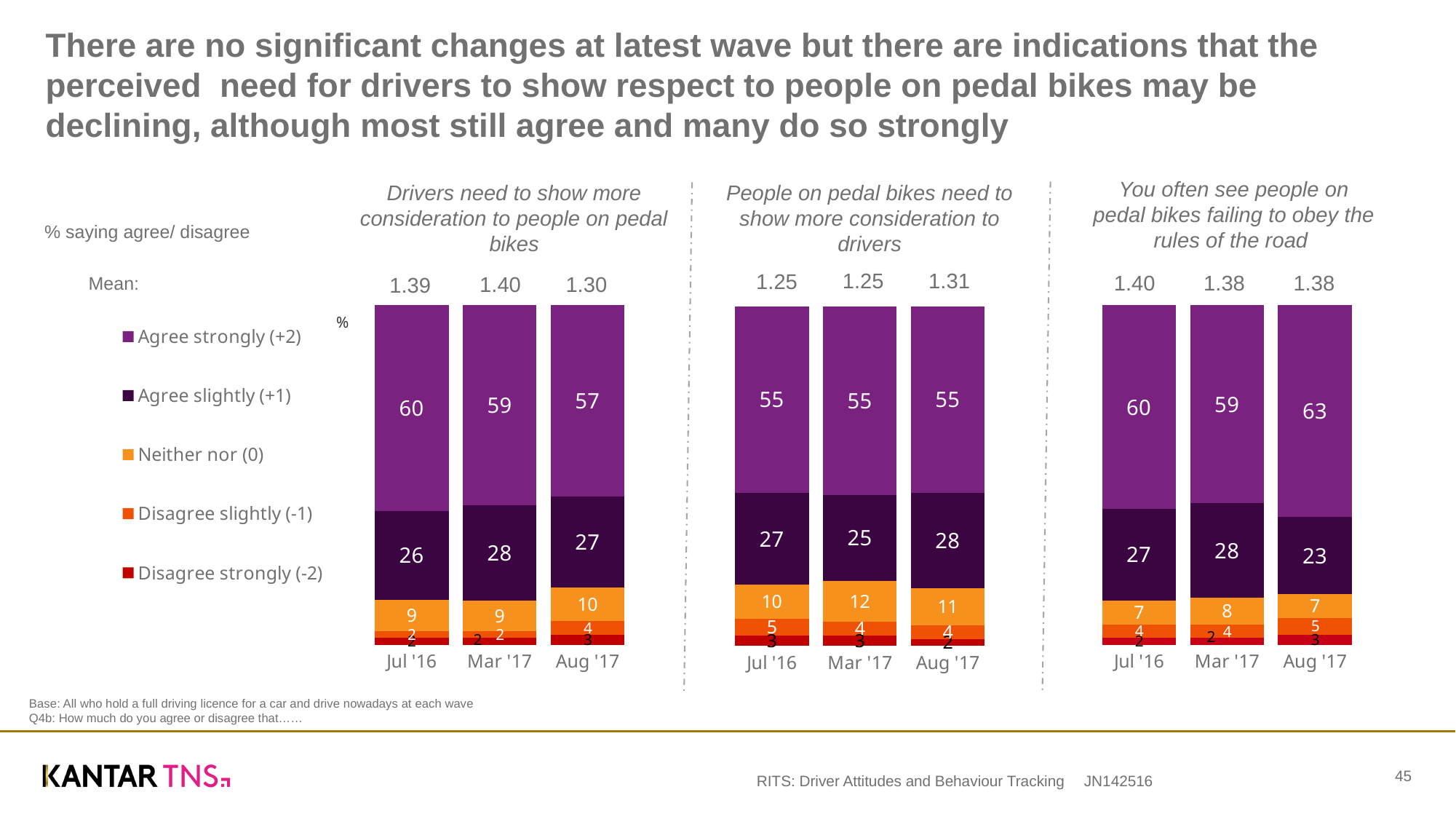
What kind of chart is used on this slide? Stacked bar chart In the chart 'You often see people on pedal bikes failing to obey the rules of the road', what percentage agreed strongly in Aug '17? 63 How many series does the legend list? 5 In the chart 'You often see people on pedal bikes failing to obey the rules of the road', what is the difference between the 'Agree slightly' percentages for Mar '17 and Aug '17? 5 In the chart 'People on pedal bikes need to show more consideration to drivers', is the 'Agree slightly' value larger in Mar '17 or Aug '17? Aug '17 In the chart 'You often see people on pedal bikes failing to obey the rules of the road', which wave has the highest 'Agree strongly' percentage? Aug '17 In the chart 'Drivers need to show more consideration to people on pedal bikes', does the 'Agree strongly' percentage rise or fall from Jul '16 to Aug '17? Fall In the chart 'Drivers need to show more consideration to people on pedal bikes', what is the mean shown for Aug '17? 1.30 How many waves (bars) are shown in each chart? 3 In the chart 'Drivers need to show more consideration to people on pedal bikes', which wave has the lowest 'Agree strongly' percentage? Aug '17 In the chart 'People on pedal bikes need to show more consideration to drivers', what percentage said 'Neither nor' in Mar '17? 12 In the chart 'Drivers need to show more consideration to people on pedal bikes', what percentage agreed strongly in Jul '16? 60